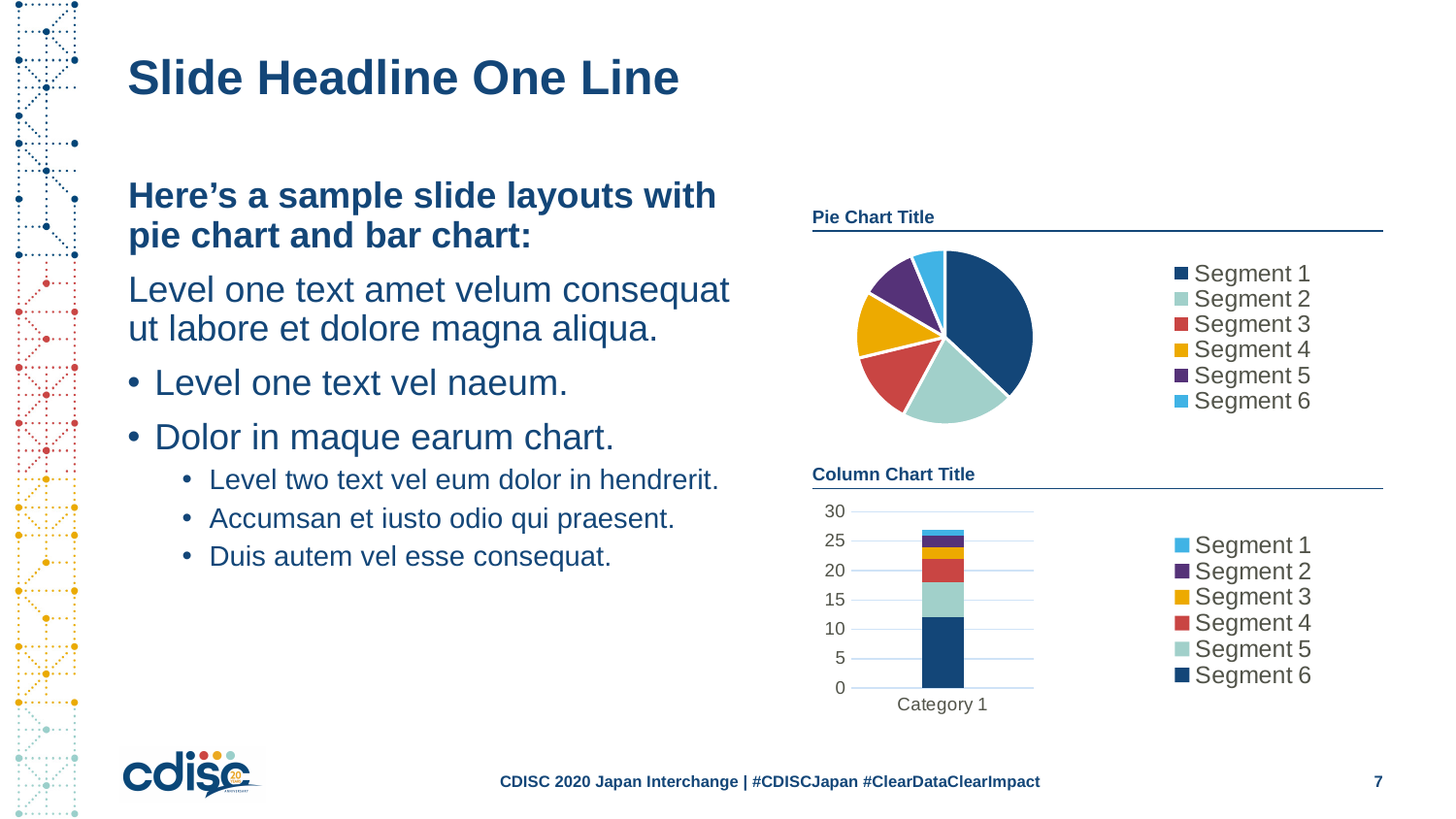
In the chart titled "Column Chart Title", is the value for Segment 6 greater or less than 10? greater What kind of chart is the chart titled "Pie Chart Title"? pie chart In the chart titled "Pie Chart Title", which segment has the smallest slice? Segment 6 In the chart titled "Column Chart Title", how many categories are shown on the x axis? 1 In the chart titled "Column Chart Title", which segment contributes the largest portion of the stacked bar? Segment 6 In the chart titled "Column Chart Title", how many series does the legend list? 6 In the chart titled "Pie Chart Title", how many segments does the legend list? 6 In the chart titled "Column Chart Title", is the total height of the stacked bar greater or less than 30? less In the chart titled "Pie Chart Title", which segment has the largest slice? Segment 1 In the chart titled "Pie Chart Title", which slice is larger, Segment 1 or Segment 2? Segment 1 In the chart titled "Column Chart Title", what is the label of the category on the x axis? Category 1 What kind of chart is the chart titled "Column Chart Title"? bar chart